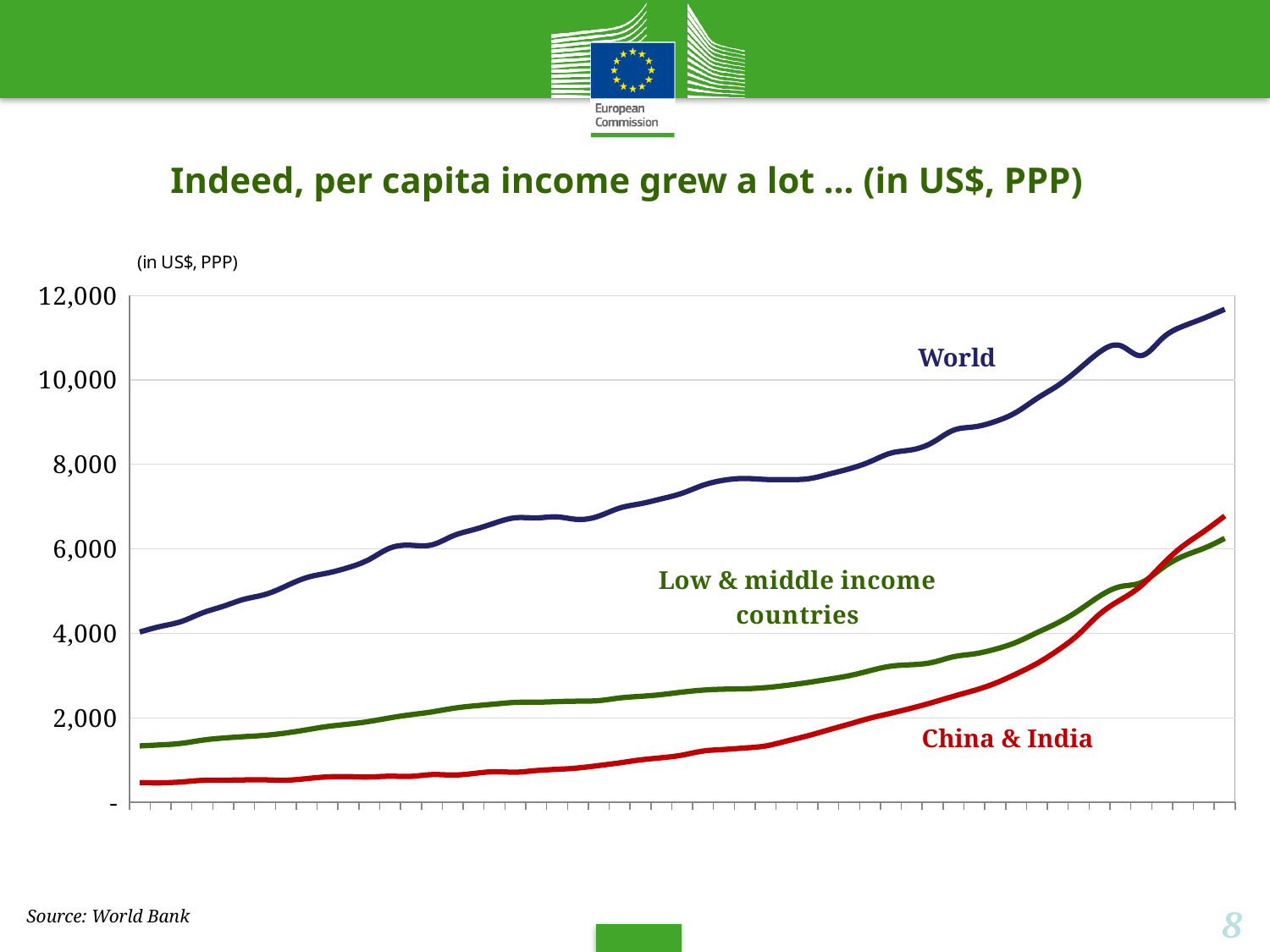
At the right end of the chart, which is larger: China & India or Low & middle income countries? China & India Which series has the lowest values at the left end of the chart? China & India How many series are plotted on the chart? 3 What kind of chart is shown on the slide? line chart Is the value of the China & India series at the left end of the chart greater or less than 2,000? less Does the China & India series rise or fall from left to right? rise Is the value of the World series at the right end of the chart greater or less than 10,000? greater What colour is the line for China & India? red Which series has the highest values throughout the chart? World What unit is stated above the chart's y axis? (in US$, PPP) Is the value of the Low & middle income countries series at the right end of the chart greater or less than 6,000? greater Does the World series rise or fall from left to right? rise